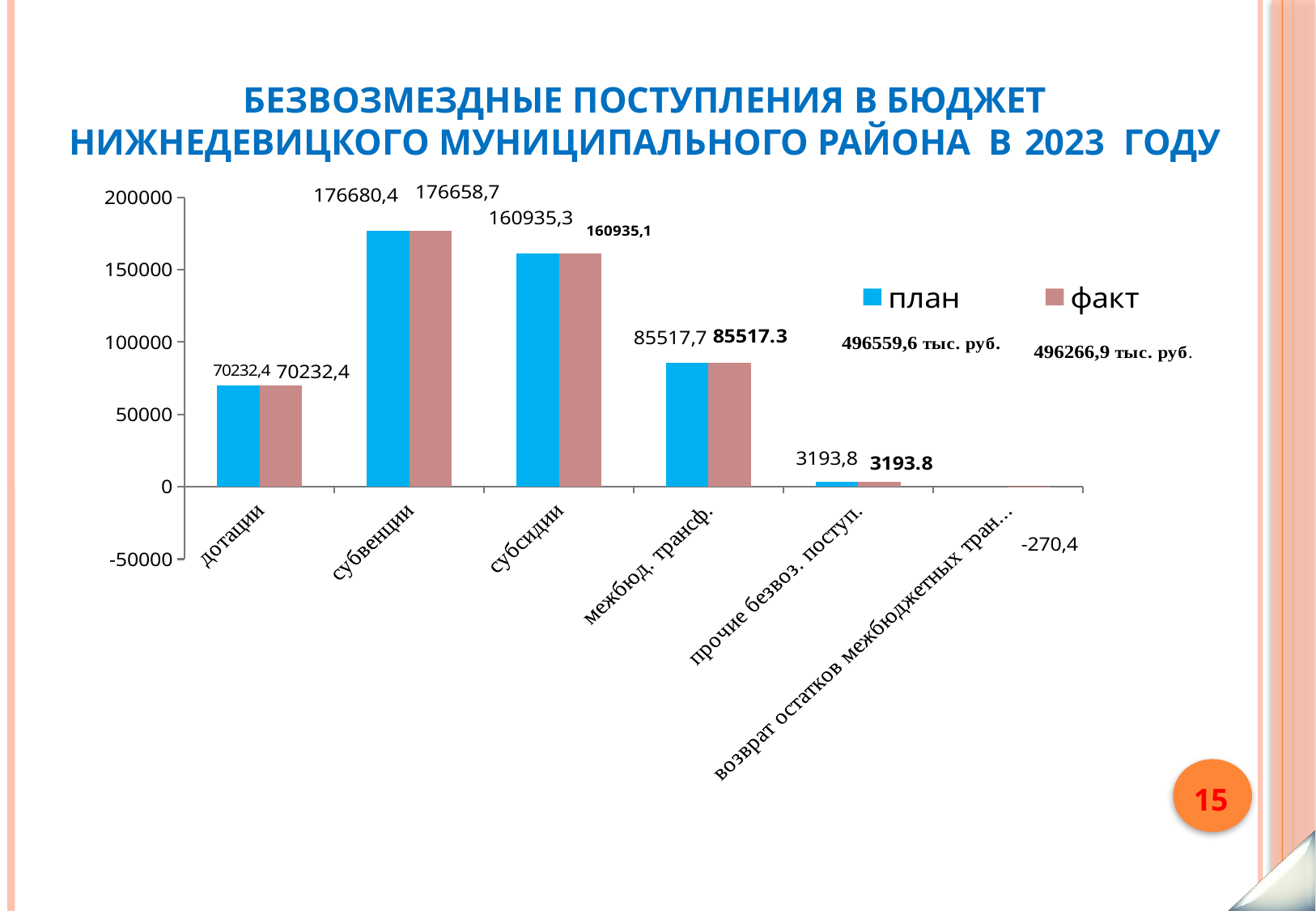
How many categories are shown on the x axis? 6 What is the план value for дотации? 70232,4 What is the план value for субвенции? 176680,4 What is the план value for прочие безвоз. поступ.? 3193,8 What is the факт value for субсидии? 160935,1 What is the факт value for межбюд. трансф.? 85517.3 Is the факт value for межбюд. трансф. greater or less than 100000? less What is the difference between the план and факт values for субвенции? 21,7 Which category has the highest план value? субвенции How many series does the legend list? 2 What kind of chart is shown on the slide? bar chart Which is larger, the план value for субвенции or the план value for субсидии? субвенции